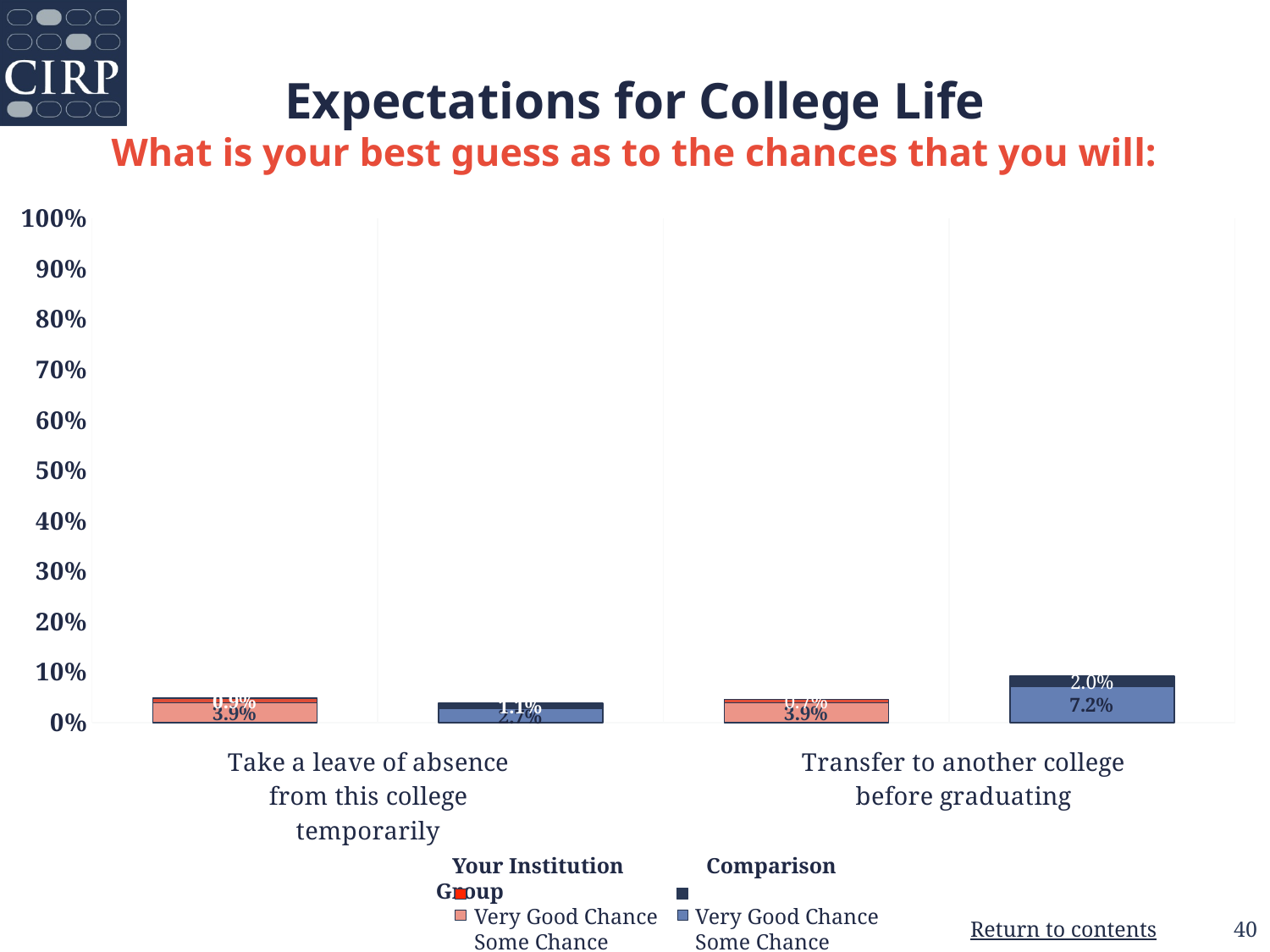
What is the Comparison Group's 'Very Good Chance' value for 'Take a leave of absence from this college temporarily'? 1.1% What is the Comparison Group's 'Very Good Chance' value for 'Transfer to another college before graduating'? 2.0% What is the total of the Comparison Group's stacked bar for 'Transfer to another college before graduating'? 9.2% What is the Comparison Group's 'Some Chance' value for 'Transfer to another college before graduating'? 7.2% What is Your Institution's 'Some Chance' value for 'Take a leave of absence from this college temporarily'? 3.9% How many series does the legend list? 4 Which stacked bar is the tallest on the chart? Comparison Group, Transfer to another college before graduating How many expectation categories are shown along the x axis? 2 What kind of chart is shown on the slide? Stacked bar chart Is the total of the Comparison Group's stacked bar for 'Transfer to another college before graduating' greater or less than 10%? less For 'Transfer to another college before graduating', which has the larger 'Some Chance' value: Your Institution or the Comparison Group? Comparison Group For 'Transfer to another college before graduating', what is the difference between the Comparison Group's and Your Institution's 'Some Chance' values? 3.3%